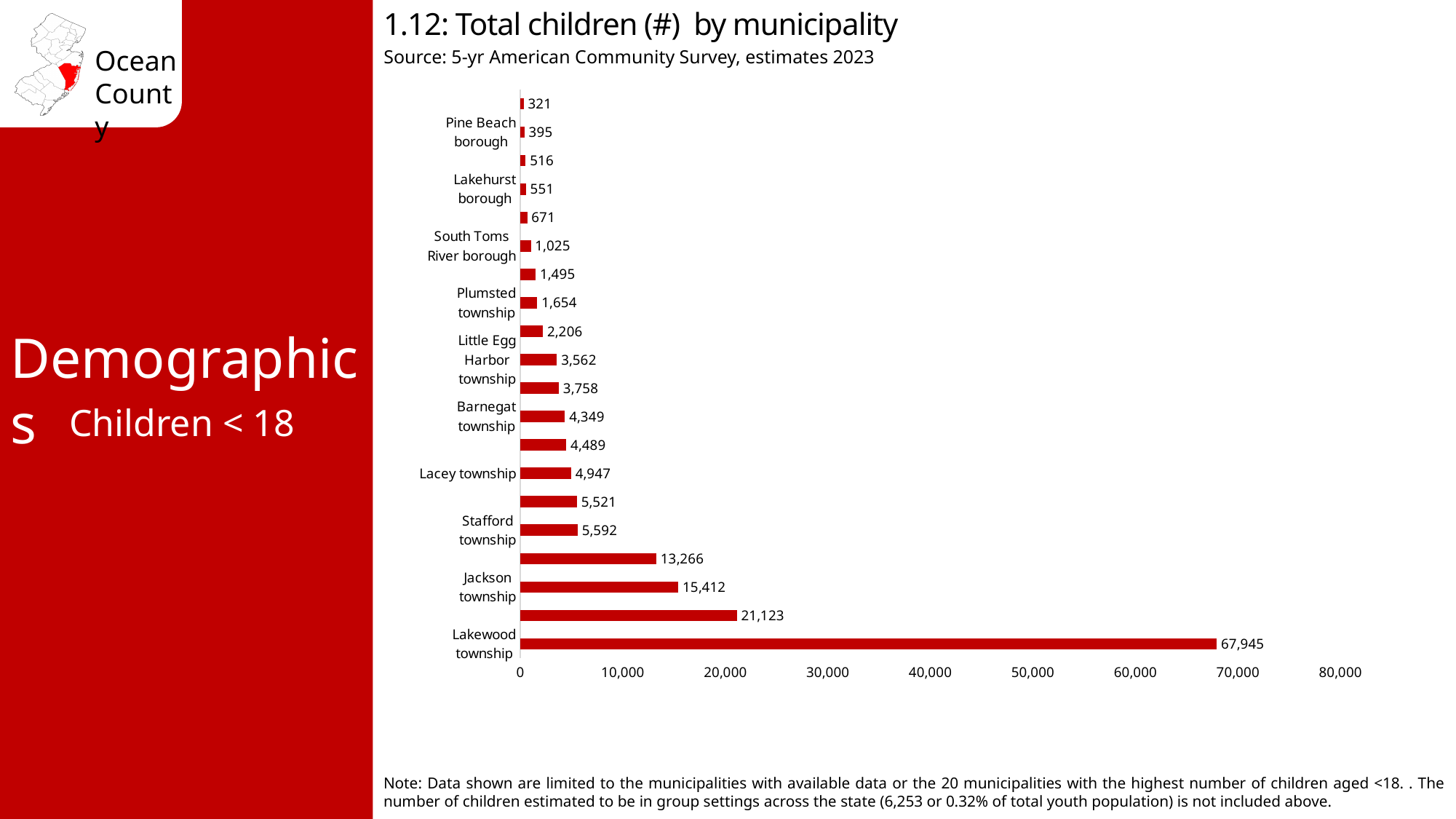
Which has more children, Barnegat township or Little Egg Harbor township? Barnegat township What is the total number of children for Pine Beach borough? 395 What is the difference between the number of children in Lakewood township and Jackson township? 52,533 Is the value for Jackson township greater or less than 10,000? greater What is the smallest value shown on the chart? 321 What is the total number of children for Lakewood township? 67,945 What is the total number of children for Stafford township? 5,592 Which municipality has the highest number of children? Lakewood township What is the total number of children for Lacey township? 4,947 What type of chart is used on this slide? Bar chart How many bars are shown on the chart? 20 What is the total number of children for Jackson township? 15,412